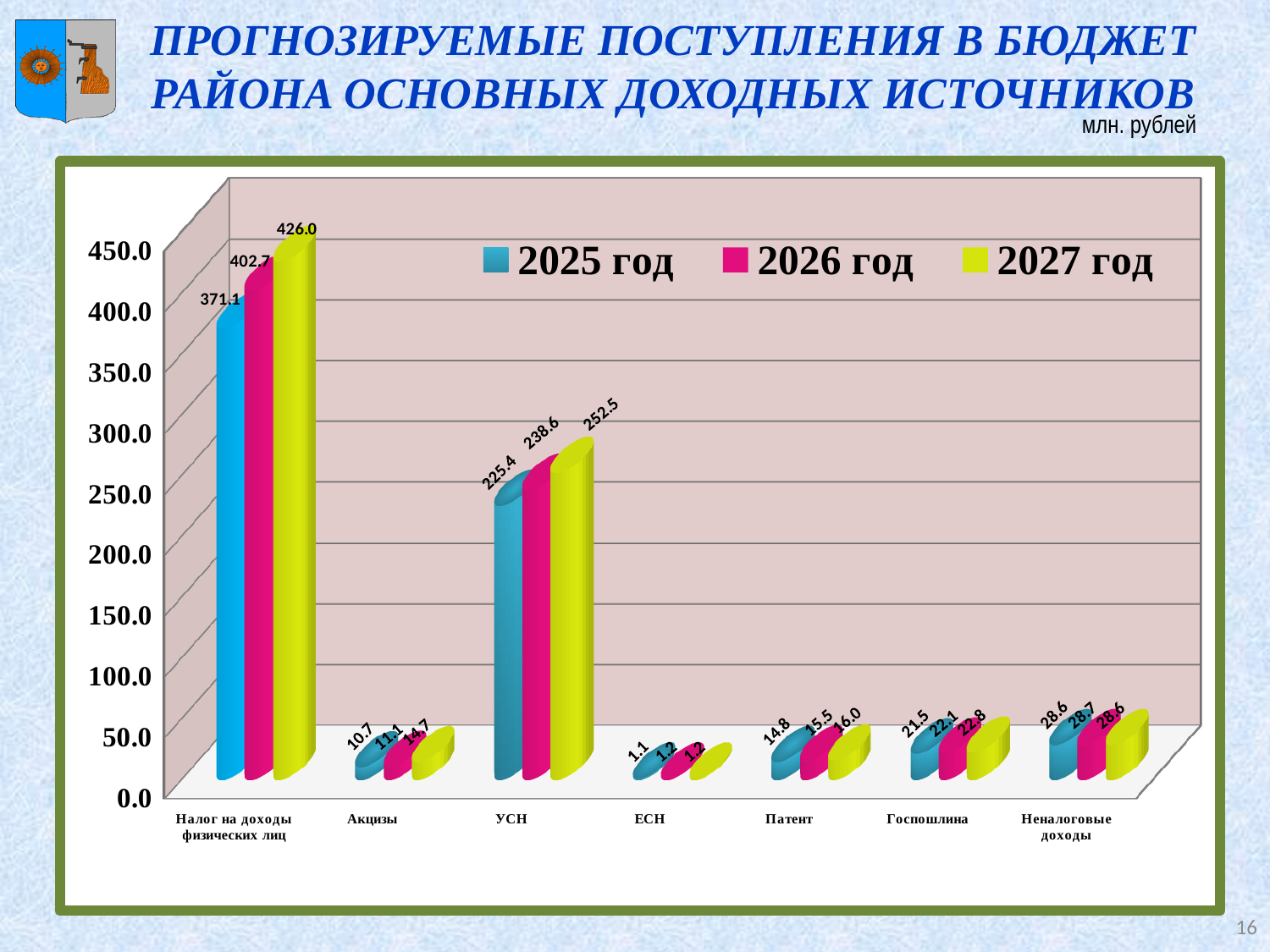
What is the value for УСН in the 2025 год series? 225.4 What is the difference between the 2027 год and 2025 год values for Налог на доходы физических лиц? 54.9 Do the values for УСН rise or fall from 2025 год to 2027 год? Rise How many series does the legend list? 3 How many categories are shown on the x axis? 7 What is the value for Госпошлина in the 2026 год series? 22.1 What is the value for Налог на доходы физических лиц in the 2027 год series? 426.0 Which is larger: the 2027 год value for Патент or the 2027 год value for Госпошлина? Госпошлина Which category has the highest value in the 2025 год series? Налог на доходы физических лиц Which category has the lowest value in the 2027 год series? ЕСН What is the difference between the 2026 год and 2025 год values for УСН? 13.2 What kind of chart is shown on the slide? Bar chart